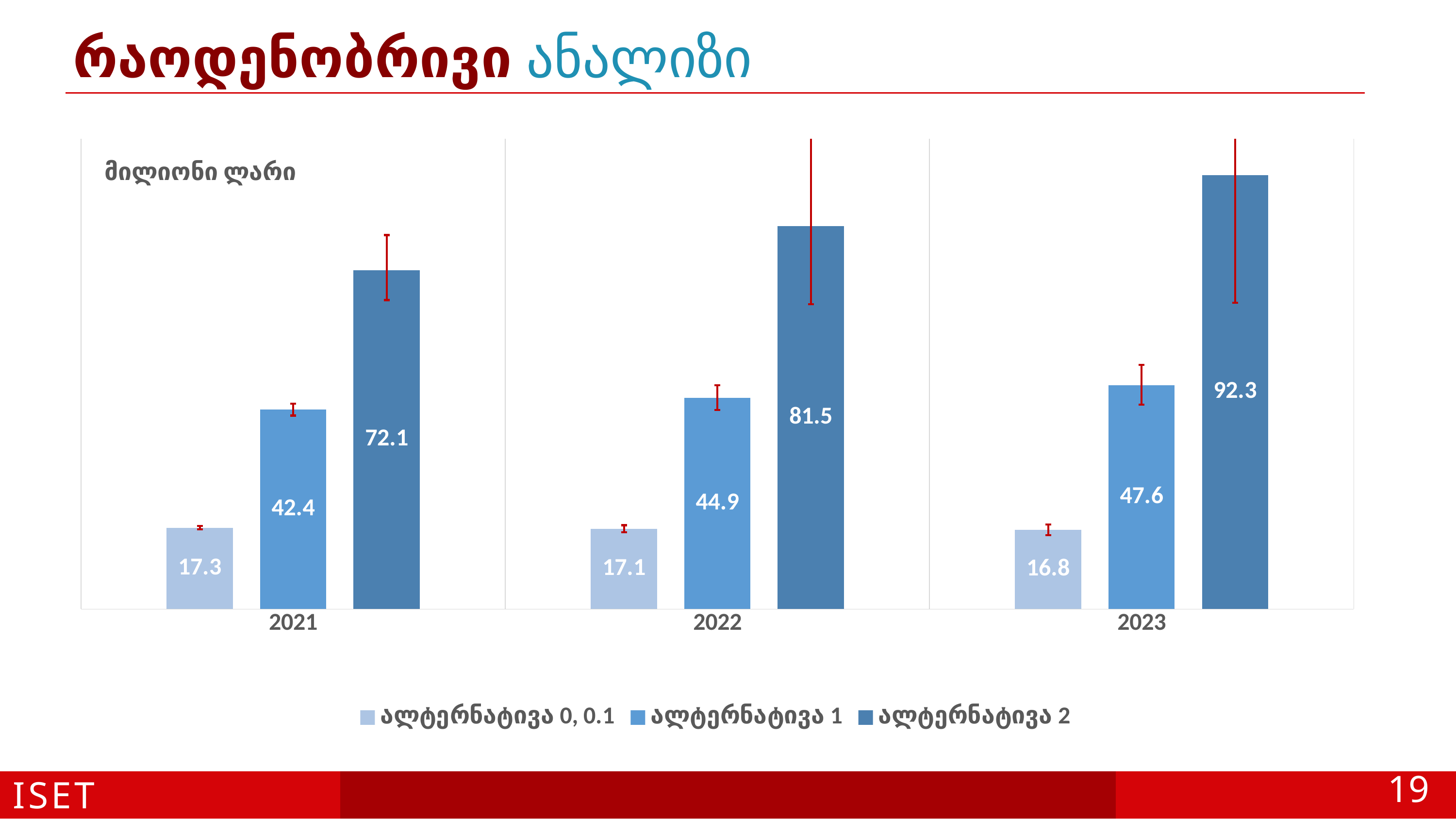
What unit is stated in the top-left corner of the chart? მილიონი ლარი Which year has the lowest value for ალტერნატივა 0, 0.1? 2023 Which year has the highest value for ალტერნატივა 2? 2023 How many series does the legend list? 3 How many years are shown on the x axis? 3 What is the value for ალტერნატივა 1 in 2021? 42.4 What is the value for ალტერნატივა 2 in 2023? 92.3 What is the value for ალტერნატივა 0, 0.1 in 2022? 17.1 What kind of chart is shown on the slide? bar chart What is the difference between ალტერნატივა 2 and ალტერნატივა 1 in 2022? 36.6 Which is larger: ალტერნატივა 1 in 2023 or ალტერნატივა 1 in 2021? ალტერნატივა 1 in 2023 Do the values for ალტერნატივა 2 rise or fall from 2021 to 2023? rise